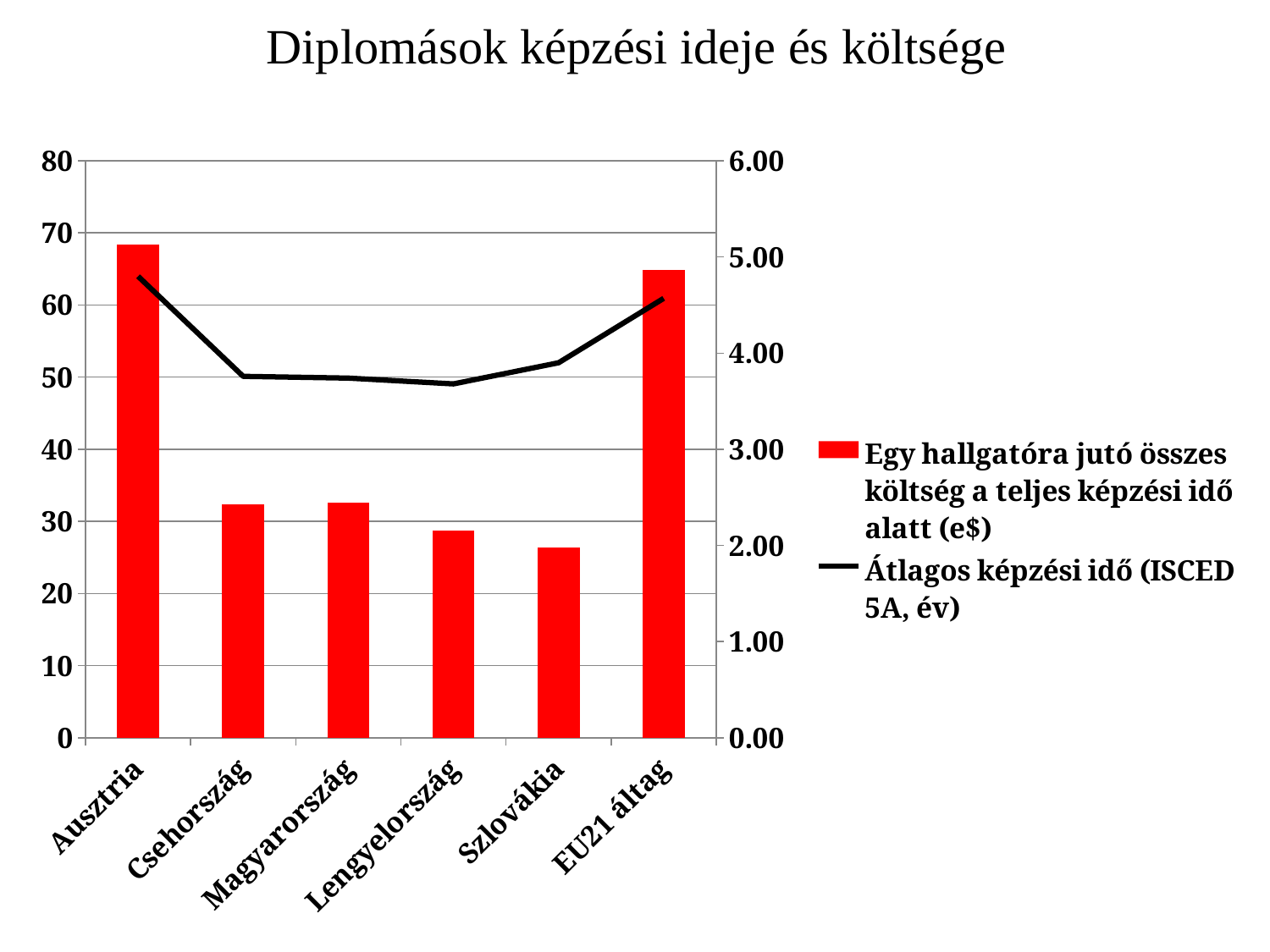
Which has a higher bar value, Ausztria or Csehország? Ausztria Is the bar value for Szlovákia greater or less than 30? less Is the 'Átlagos képzési idő' value for Lengyelország greater or less than 4.00? less What kind of chart is this? Combined bar and line chart What colour are the bars in the chart? Red Which category has the highest value for 'Átlagos képzési idő (ISCED 5A, év)'? Ausztria Which category has the highest bar for 'Egy hallgatóra jutó összes költség a teljes képzési idő alatt (e$)'? Ausztria How many series does the legend list? 2 Which category has the lowest bar for 'Egy hallgatóra jutó összes költség a teljes képzési idő alatt (e$)'? Szlovákia Is the bar value for EU21 áltag greater or less than 60? greater What is the title of the chart? Diplomások képzési ideje és költsége How many countries/categories are shown on the x axis? 6